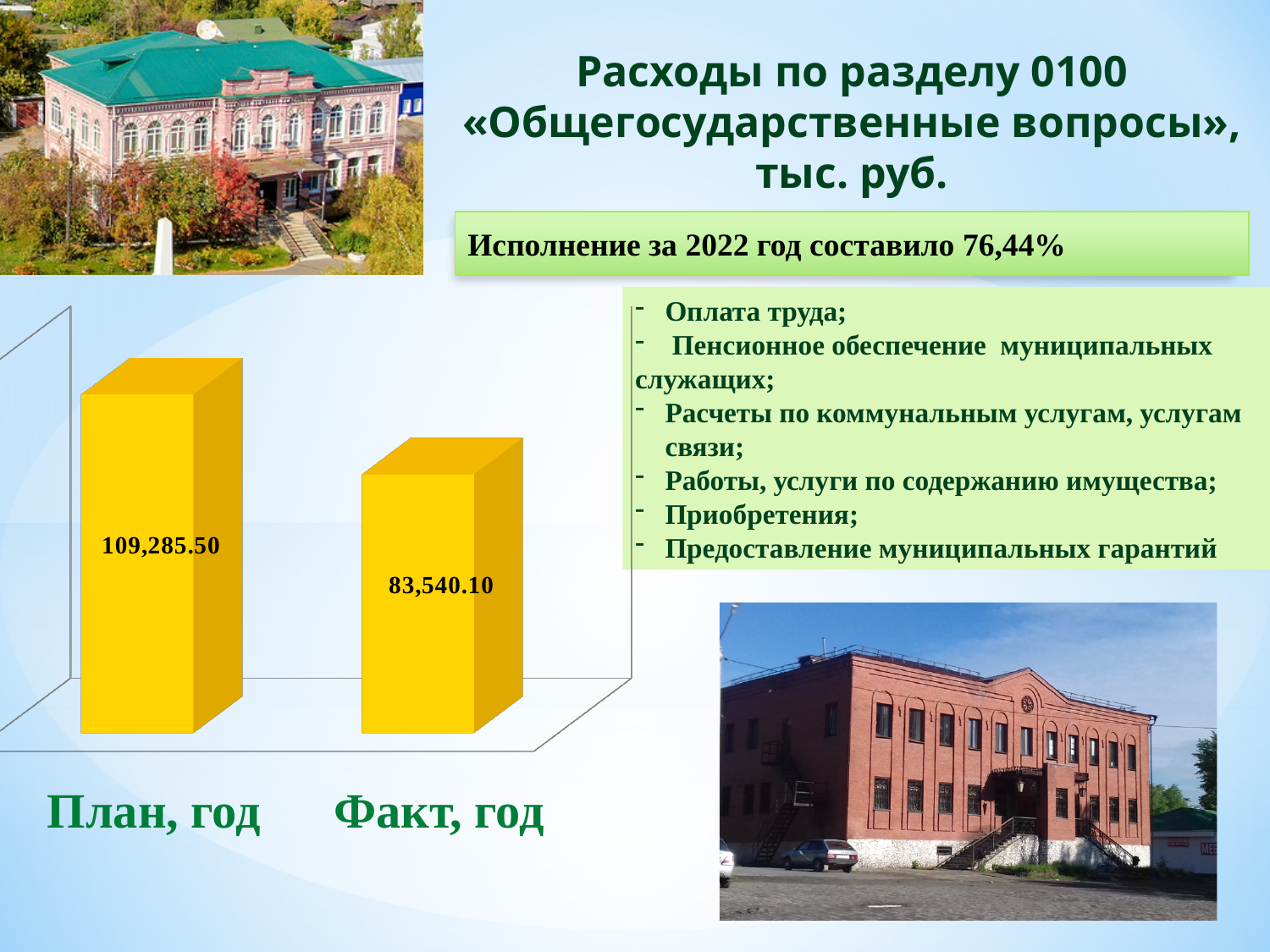
In what units are the expenses on the chart expressed, according to the slide title? тыс. руб. What kind of chart is shown on the slide? Bar chart What colour are the bars on the chart? Yellow How many bars are shown on the chart? 2 Which bar is the lowest on the chart? Факт, год What is the value of the bar labelled «Факт, год»? 83,540.10 What is the value of the bar labelled «План, год»? 109,285.50 Do the values rise or fall from «План, год» to «Факт, год»? Fall What is the difference between the «План, год» and «Факт, год» values? 25,745.40 Which is larger, the value for «План, год» or the value for «Факт, год»? План, год Which bar is the highest on the chart? План, год